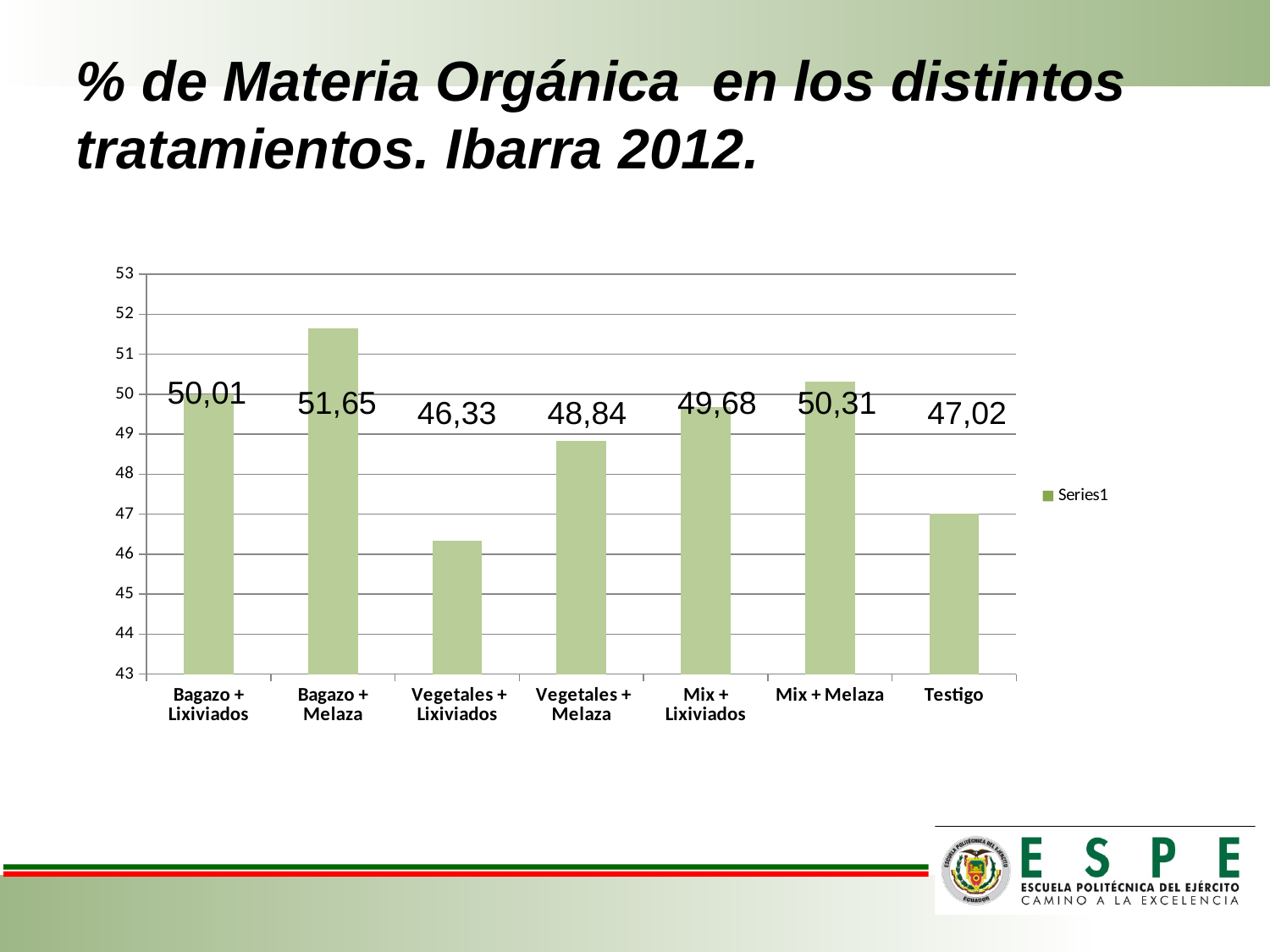
What kind of chart is shown on the slide? Bar chart What is the difference between the values for Bagazo + Melaza and Vegetales + Lixiviados? 5,32 What is the value for Vegetales + Lixiviados? 46,33 What is the value for Bagazo + Melaza? 51,65 What is the name of the series listed in the legend? Series1 What is the difference between the values for Vegetales + Melaza and Testigo? 1,82 What is the value for Mix + Lixiviados? 49,68 Which treatment has the lowest value? Vegetales + Lixiviados What is the value for Testigo? 47,02 How many treatments are shown on the x axis? 7 Which is larger, the value for Mix + Melaza or the value for Bagazo + Lixiviados? Mix + Melaza Which treatment has the highest value? Bagazo + Melaza